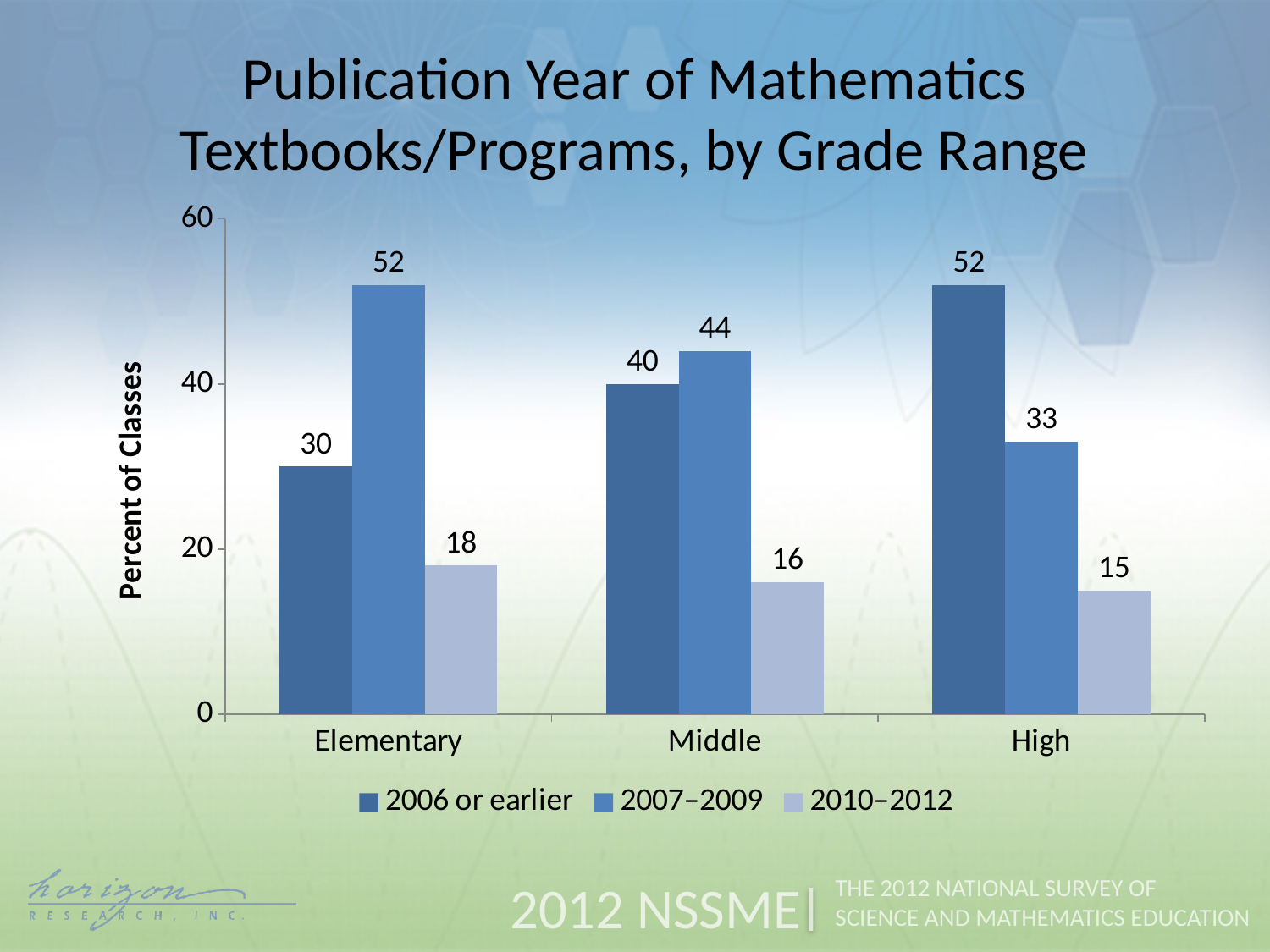
What is the value for High school classes in the 2006 or earlier series? 52 What percent of Elementary classes use mathematics textbooks published in 2007–2009? 52 How many grade ranges are shown on the x axis? 3 What is the difference between the 2007–2009 values for Elementary and High? 19 What kind of chart is shown on the slide? bar chart What is the value for Middle school classes in the 2010–2012 series? 16 What is the label of the y axis? Percent of Classes Which grade range has the highest value in the 2006 or earlier series? High How many series does the legend list? 3 Is the value for Elementary in the 2006 or earlier series greater or less than 40? less Which is larger for Middle school classes: the 2006 or earlier value or the 2007–2009 value? 2007–2009 Which grade range has the lowest value in the 2010–2012 series? High